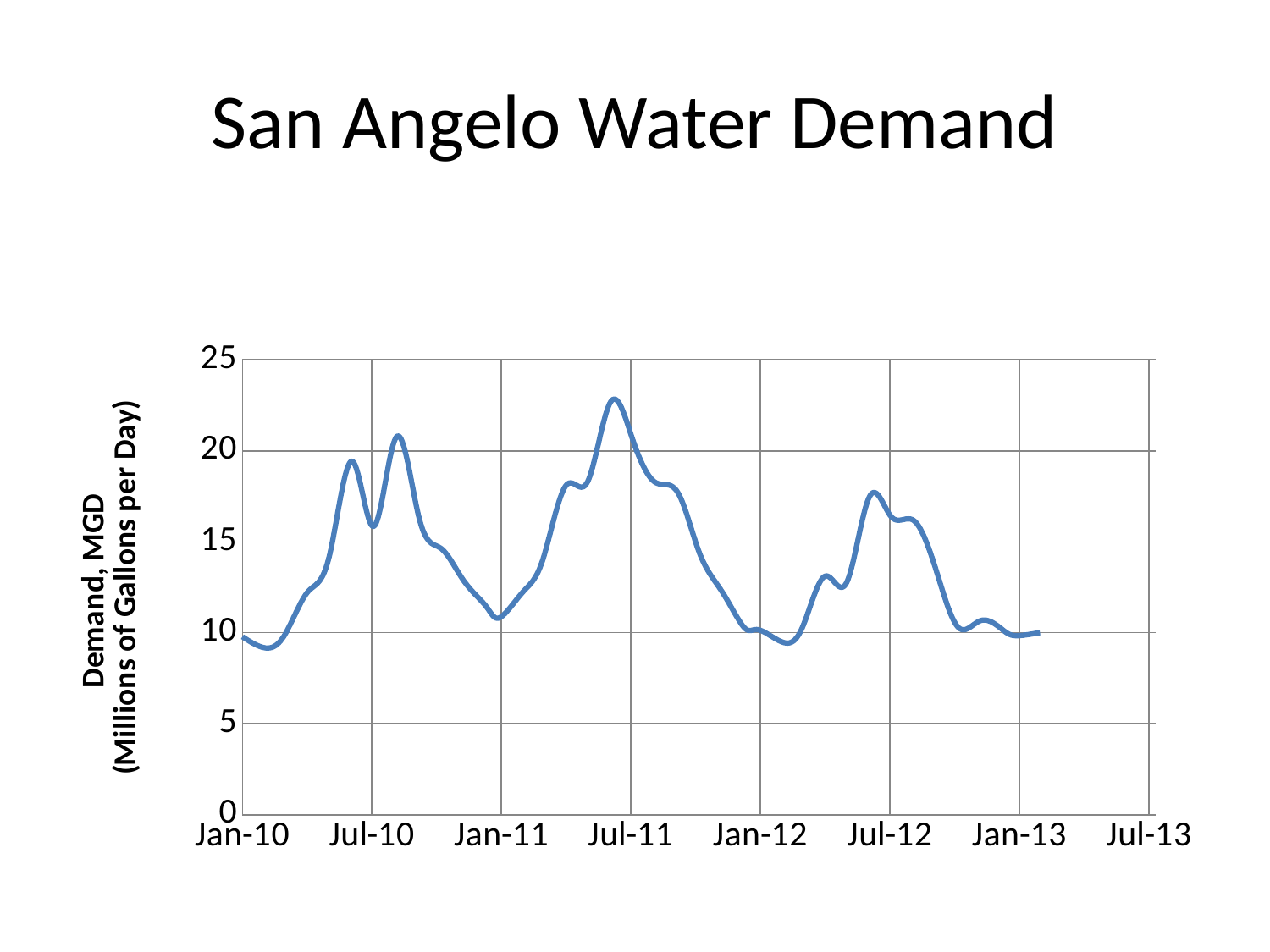
In which summer does the line reach its highest peak: 2010, 2011 or 2012? 2011 Is the value at Jul-10 greater or less than 15? greater Is the value at Jan-11 greater or less than 15? less Which is larger, the value at Jul-10 or the value at Jan-11? Jul-10 How many tick labels are shown on the horizontal axis? 8 What is the label of the vertical axis? Demand, MGD (Millions of Gallons per Day) Is the value at Jan-13 greater or less than 15? less Do the values rise or fall between Jul-11 and Jan-12? fall What is the title of the chart? San Angelo Water Demand What kind of chart is shown on the slide? line chart